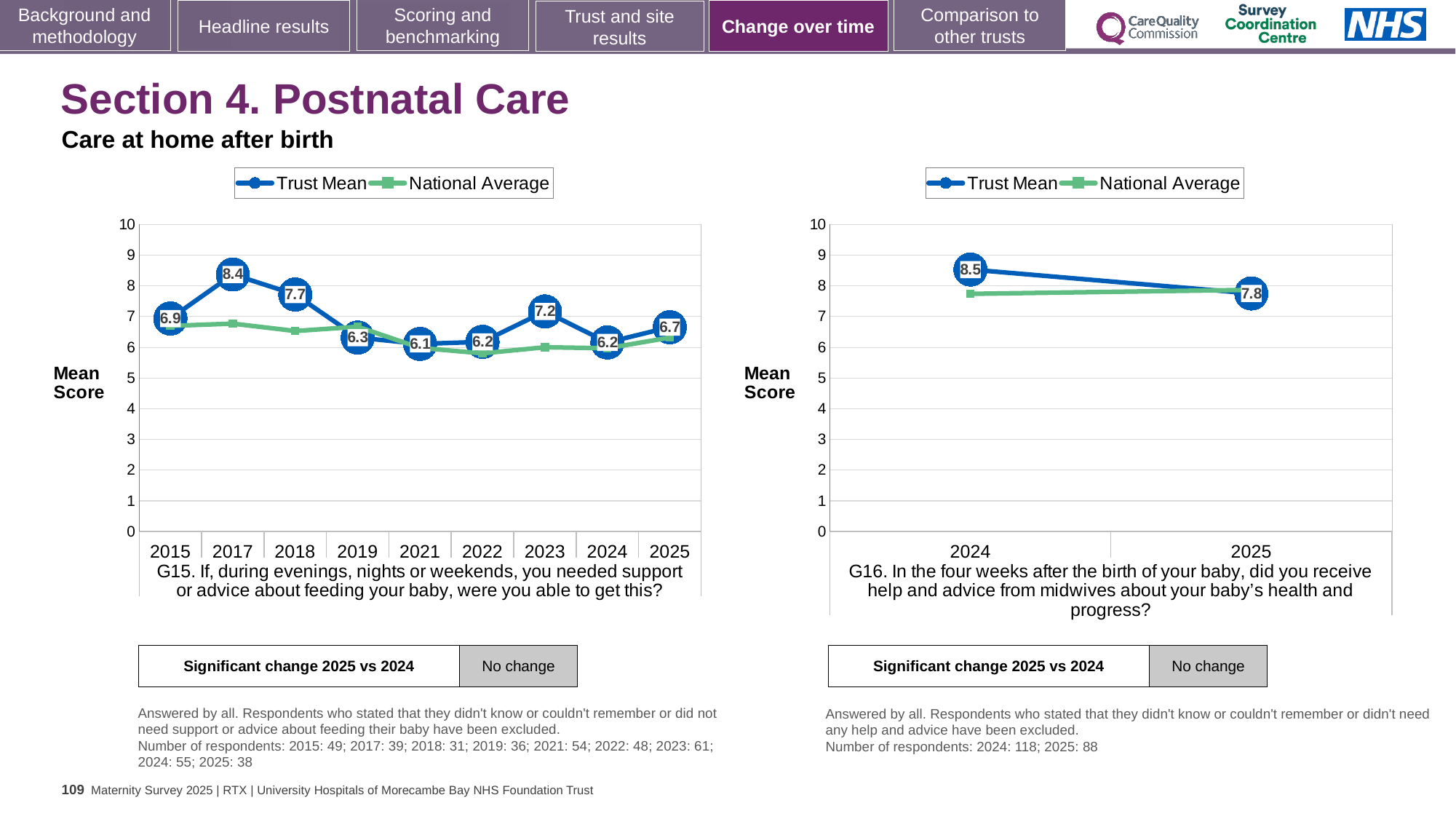
In the left chart (G15), what is the Trust Mean score for 2017? 8.4 How many series does the legend of the left chart (G15) list? 2 In the left chart (G15), how many years are plotted on the x axis? 9 In the left chart (G15), which year has the highest Trust Mean score? 2017 In the left chart (G15), what is the Trust Mean score for 2025? 6.7 In the right chart (G16), is the National Average value for 2024 greater or less than 7? greater In the right chart (G16), what is the difference between the Trust Mean scores for 2024 and 2025? 0.7 In the left chart (G15), what is the difference between the Trust Mean scores for 2017 and 2018? 0.7 In the right chart (G16), what is the Trust Mean score for 2024? 8.5 In the left chart (G15), which year has the lowest Trust Mean score? 2021 In the right chart (G16), does the Trust Mean rise or fall from 2024 to 2025? fall In the left chart (G15), is the Trust Mean score higher in 2023 or in 2024? 2023